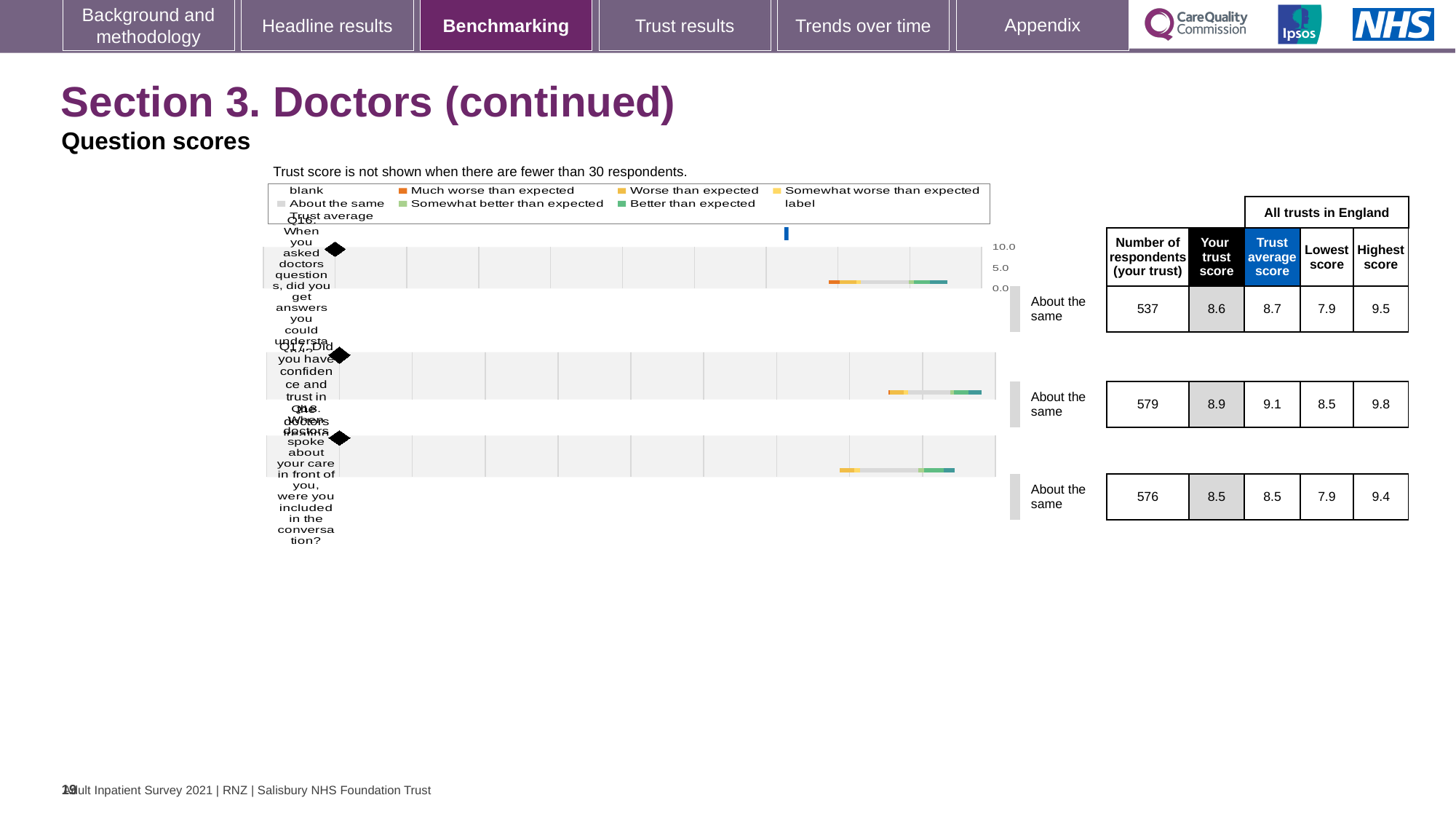
What is the highest score across all trusts in England for Q18? 9.4 What benchmark category is shown for Q18? About the same What is the 'Your trust score' for Q17 (confidence and trust in the doctors)? 8.9 What is the difference between the trust average score and your trust score for Q17? 0.2 For Q16, is your trust score higher or lower than the trust average score? lower What is the lowest score across all trusts in England for Q17? 8.5 Which question has the highest 'Your trust score'? Q17 How many respondents from your trust answered Q16? 537 How many questions are shown in the chart? 3 Which question had the most respondents from your trust? Q17 Which question has the lowest 'Your trust score'? Q18 What is the difference between the highest and lowest scores across all trusts in England for Q16? 1.6